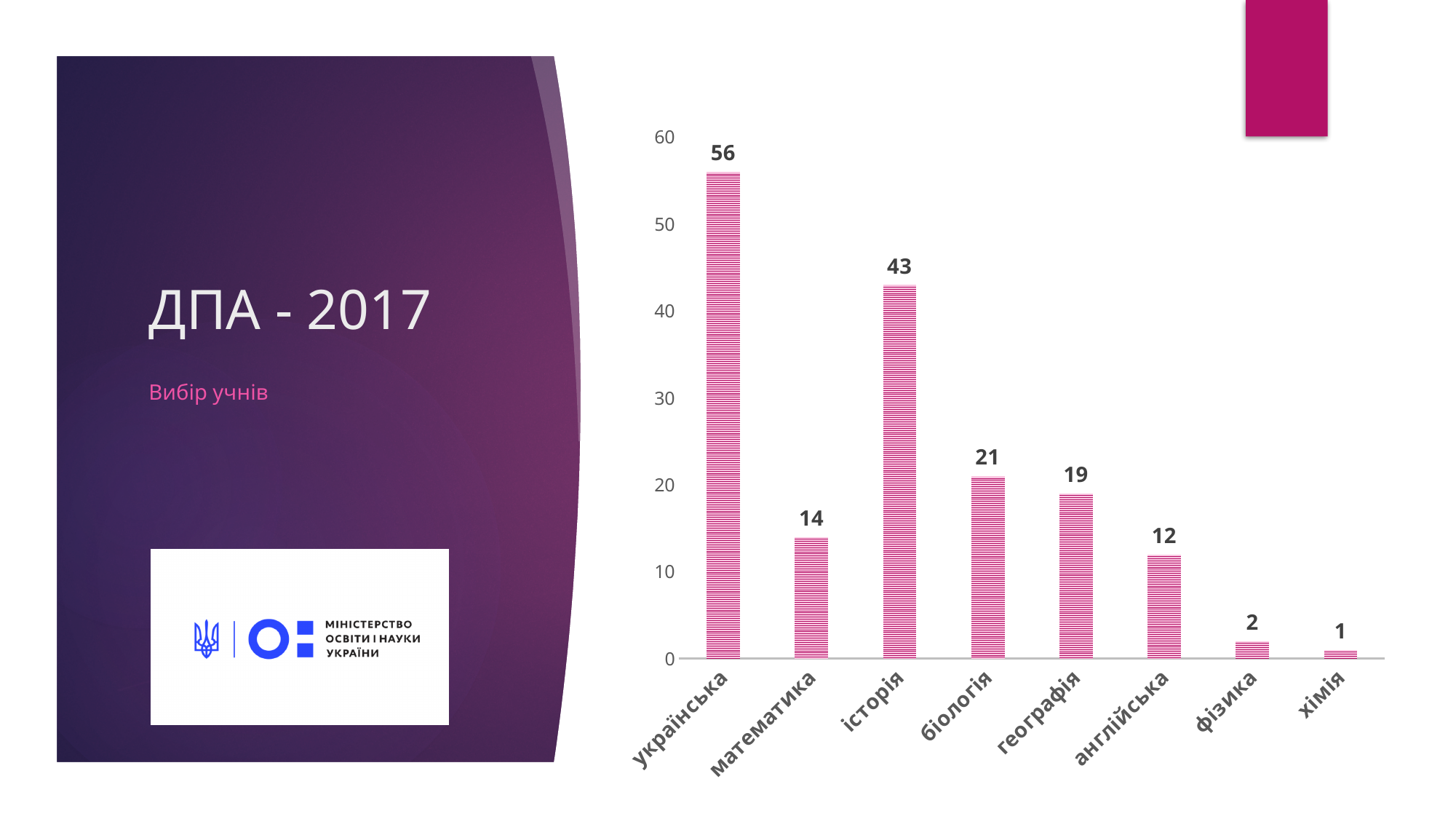
What is the difference between the values for українська and історія? 13 How many categories are shown on the x axis? 8 What is the subtitle shown under the slide title ДПА - 2017? Вибір учнів Which is larger, the value for математика or the value for англійська? математика What is the difference between the values for біологія and англійська? 9 What is the value for хімія? 1 What is the value for географія? 19 What is the value for історія? 43 What is the value for українська? 56 What kind of chart is shown on the slide? bar chart Which category has the lowest value? хімія Which category has the highest value? українська